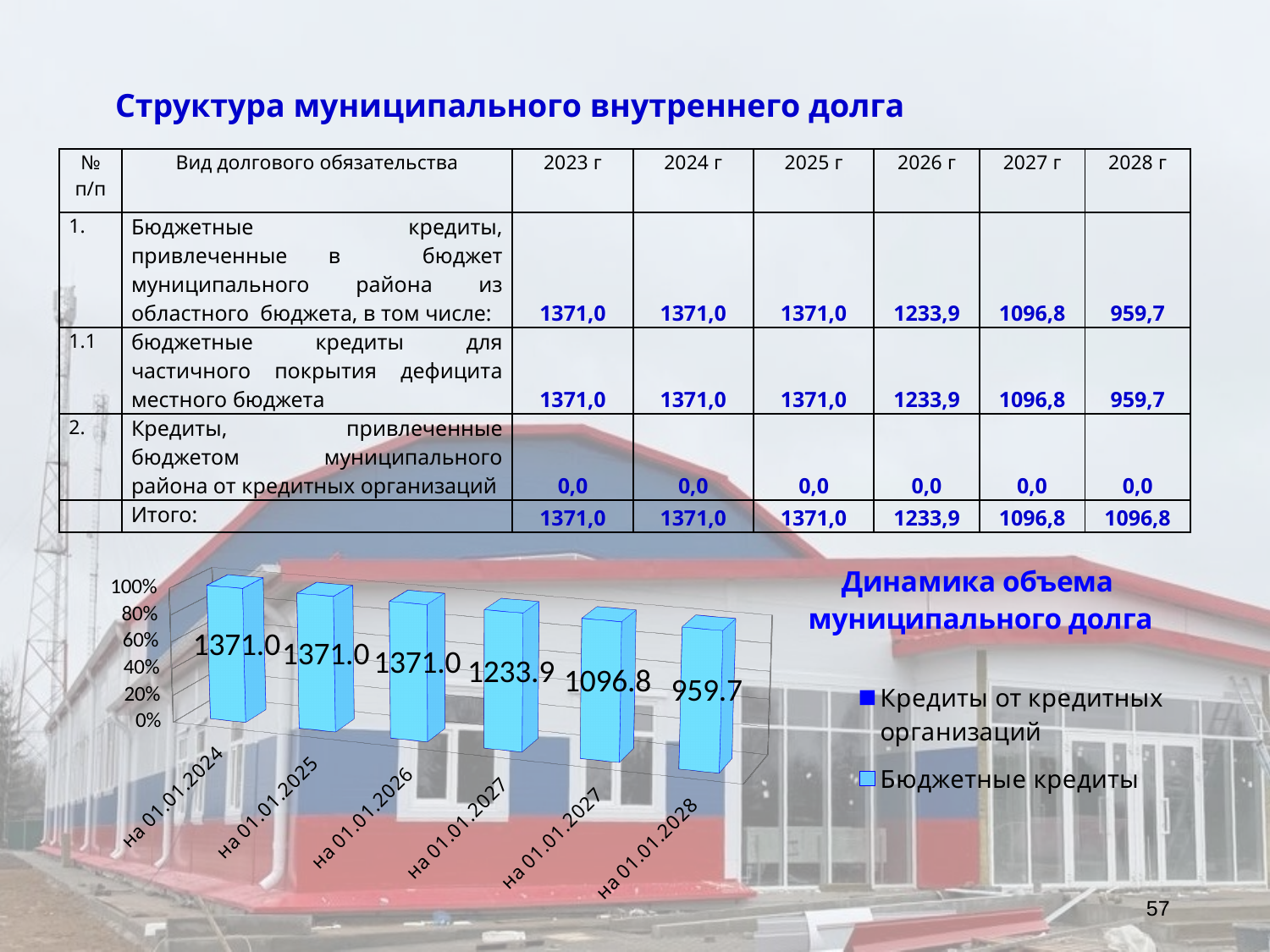
How many series does the chart legend list? 2 Which category has the lowest labelled value in the chart? на 01.01.2028 What is the title of the chart on the slide? Динамика объема муниципального долга What value is labelled on the fourth bar from the left in the chart? 1233.9 What is the difference between the labelled values for на 01.01.2024 and на 01.01.2028? 411.3 What kind of chart is shown on the slide? bar chart What value is labelled on the fifth bar from the left in the chart? 1096.8 What value is labelled on the bar for на 01.01.2024? 1371.0 What value is labelled on the bar for на 01.01.2028? 959.7 Which legend entry is shown with the light blue colour? Бюджетные кредиты Do the labelled values in the chart rise or fall from left to right? fall How many bars are plotted in the chart? 6